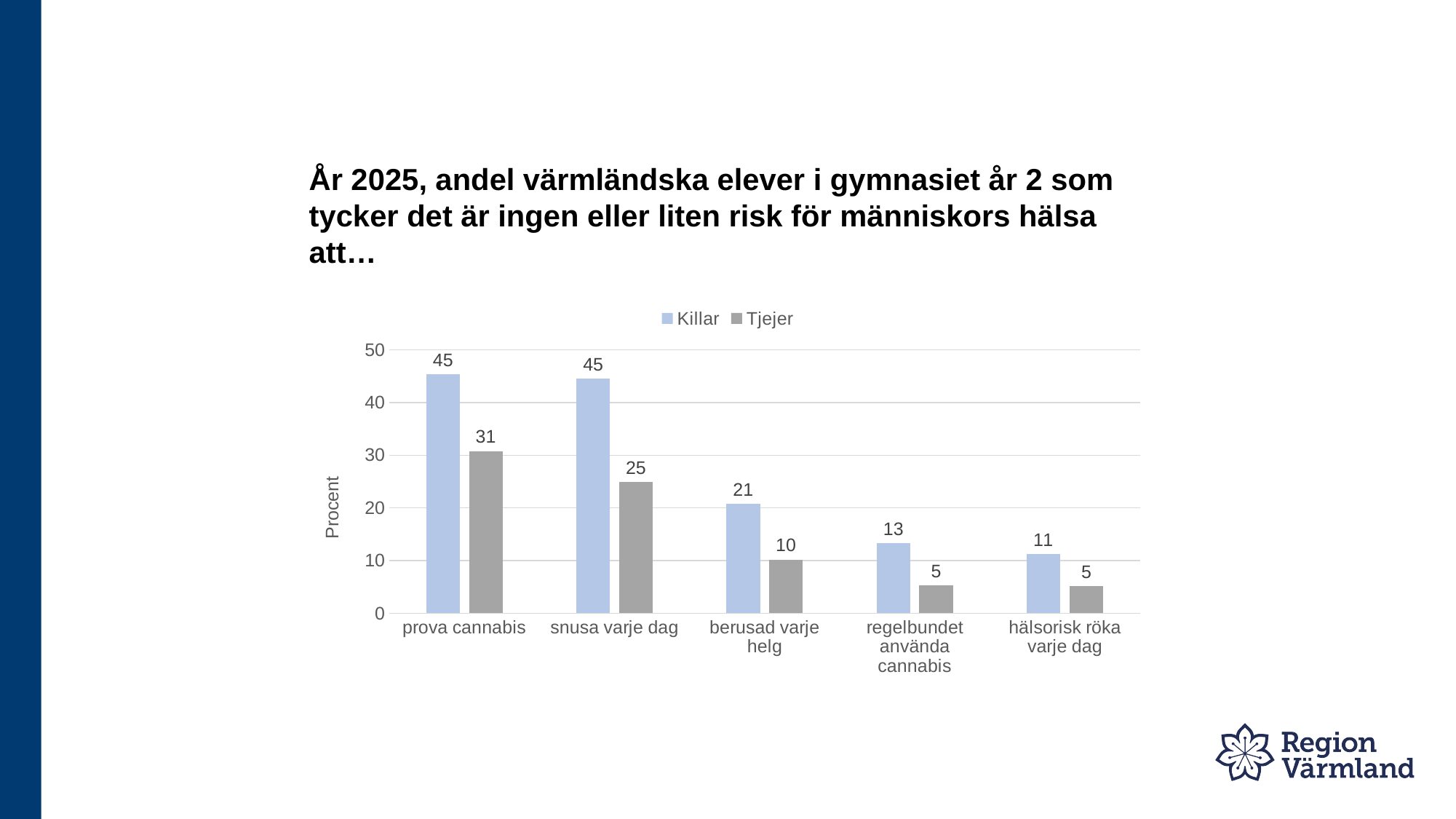
What is the value for Tjejer in the 'snusa varje dag' category? 25 How many series does the legend list? 2 What is the value for Killar in the 'regelbundet använda cannabis' category? 13 Which is larger in the 'snusa varje dag' category, Killar or Tjejer? Killar What is the value for Killar in the 'prova cannabis' category? 45 Which category has the lowest value for Killar? hälsorisk röka varje dag What is the label of the y axis? Procent How many categories are shown on the x axis? 5 What kind of chart is shown on the slide? bar chart Which category has the highest value for Tjejer? prova cannabis What is the value for Tjejer in the 'berusad varje helg' category? 10 What is the difference between Killar and Tjejer in the 'prova cannabis' category? 14